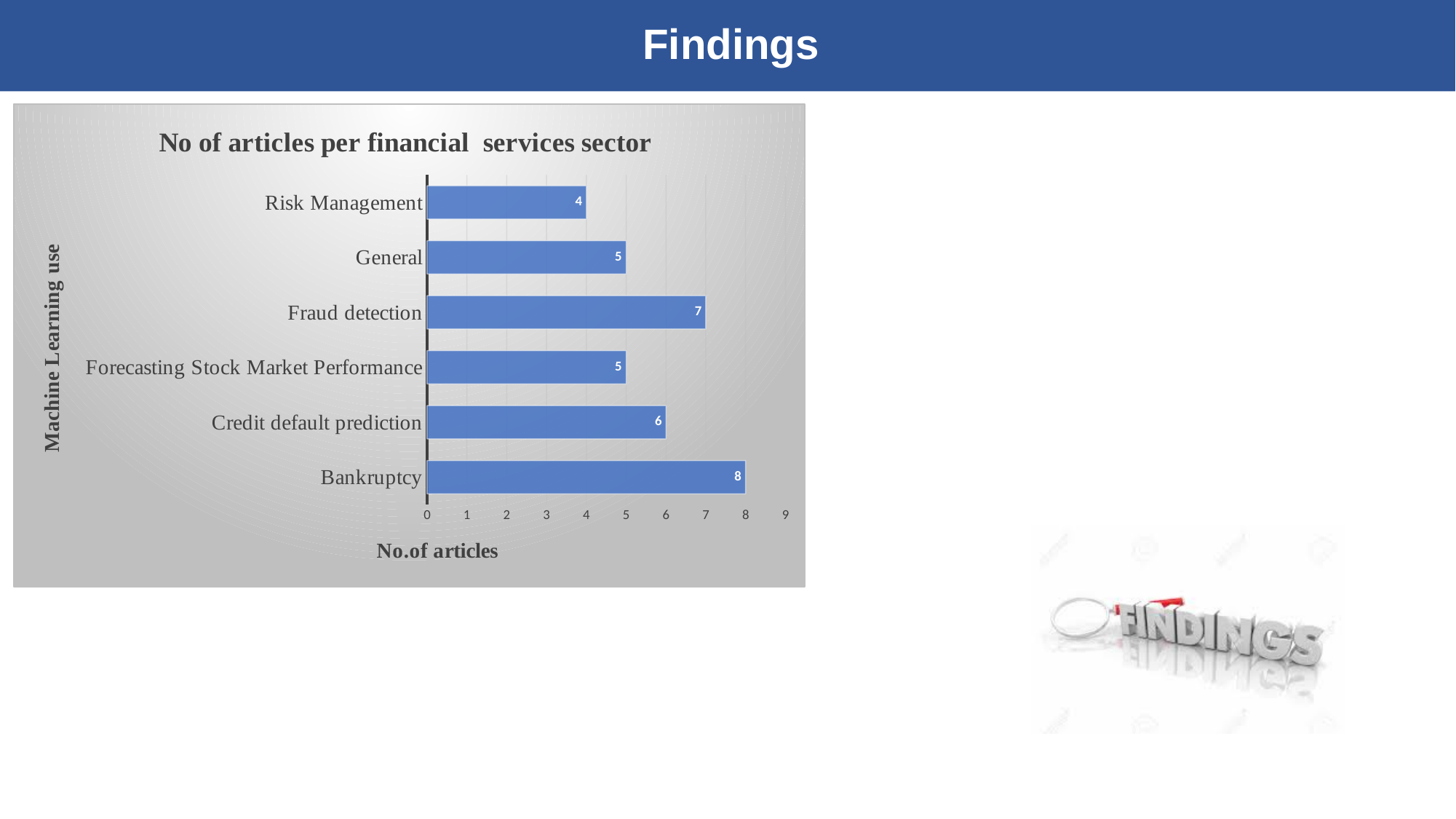
What is the number of articles for Risk Management? 4 Which machine learning use has the highest number of articles? Bankruptcy What is the title of the chart? No of articles per financial services sector Which machine learning use has the lowest number of articles? Risk Management How many machine learning use categories are shown in the chart? 6 What is the number of articles for Bankruptcy? 8 Which has more articles, Fraud detection or Credit default prediction? Fraud detection What is the difference in number of articles between Bankruptcy and Risk Management? 4 What is the number of articles for Credit default prediction? 6 What kind of chart is shown on the slide? Bar chart What is the label of the horizontal axis of the chart? No.of articles What is the number of articles for Fraud detection? 7